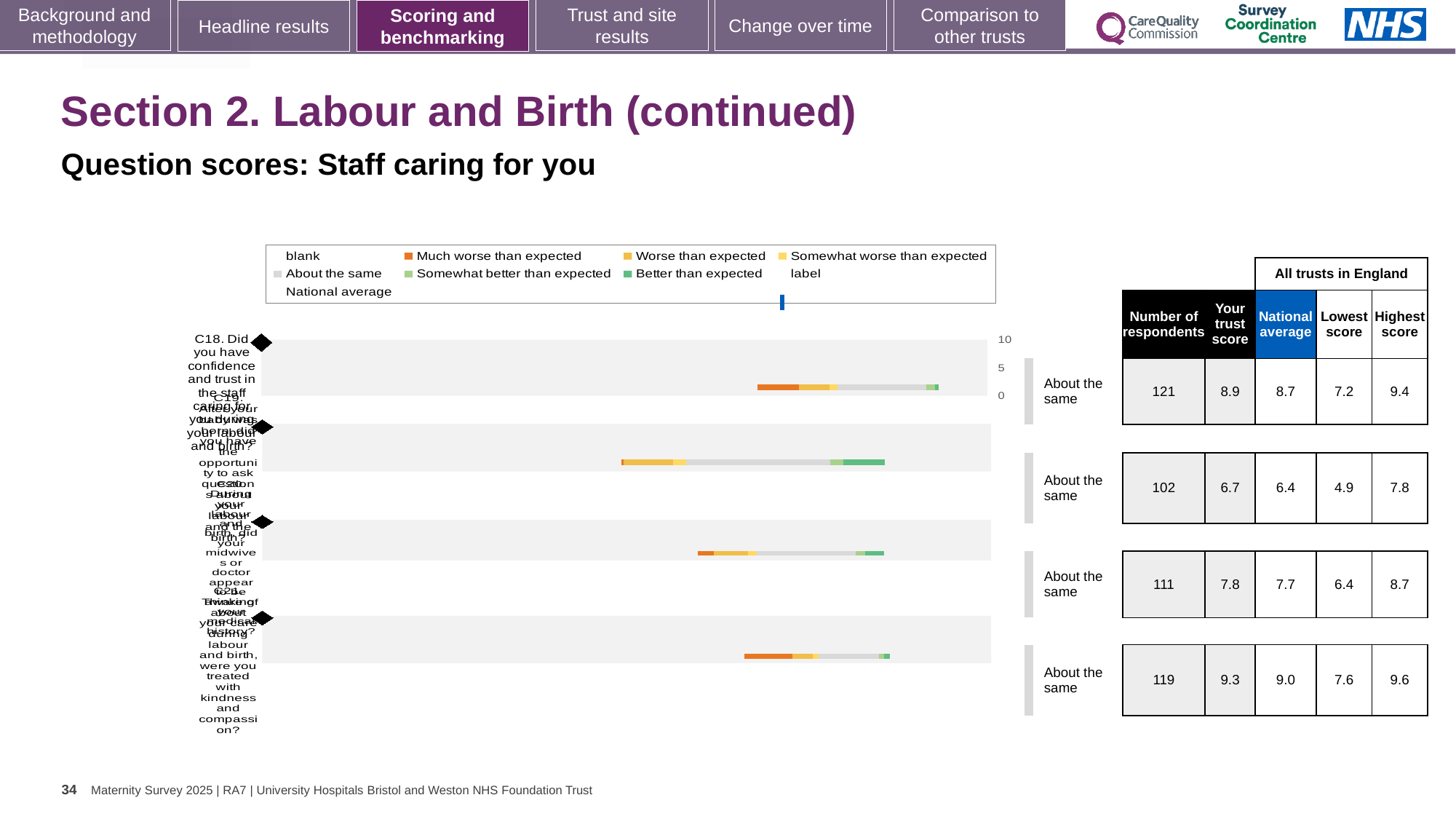
How many entries does the chart legend list? 9 In the table, what is the national average for the second row (C19)? 6.4 In the fourth row of the table, which is larger: 'Your trust score' or the national average? Your trust score In the table, what is the number of respondents for the third row (C20)? 111 What kind of chart is shown on the slide? bar chart In the first row of the table, what is the difference between 'Your trust score' and the national average? 0.2 Which row of the table has the lowest 'Your trust score'? the second row (C19), 6.7 How many question categories (bars) are plotted in the chart? 4 In the table, what is 'Your trust score' for the first row (C18)? 8.9 What colour does the legend use for 'Much worse than expected'? orange Which row of the table has the highest 'Your trust score'? the fourth row (C21), 9.3 What is the subtitle describing the question scores shown on the slide? Question scores: Staff caring for you